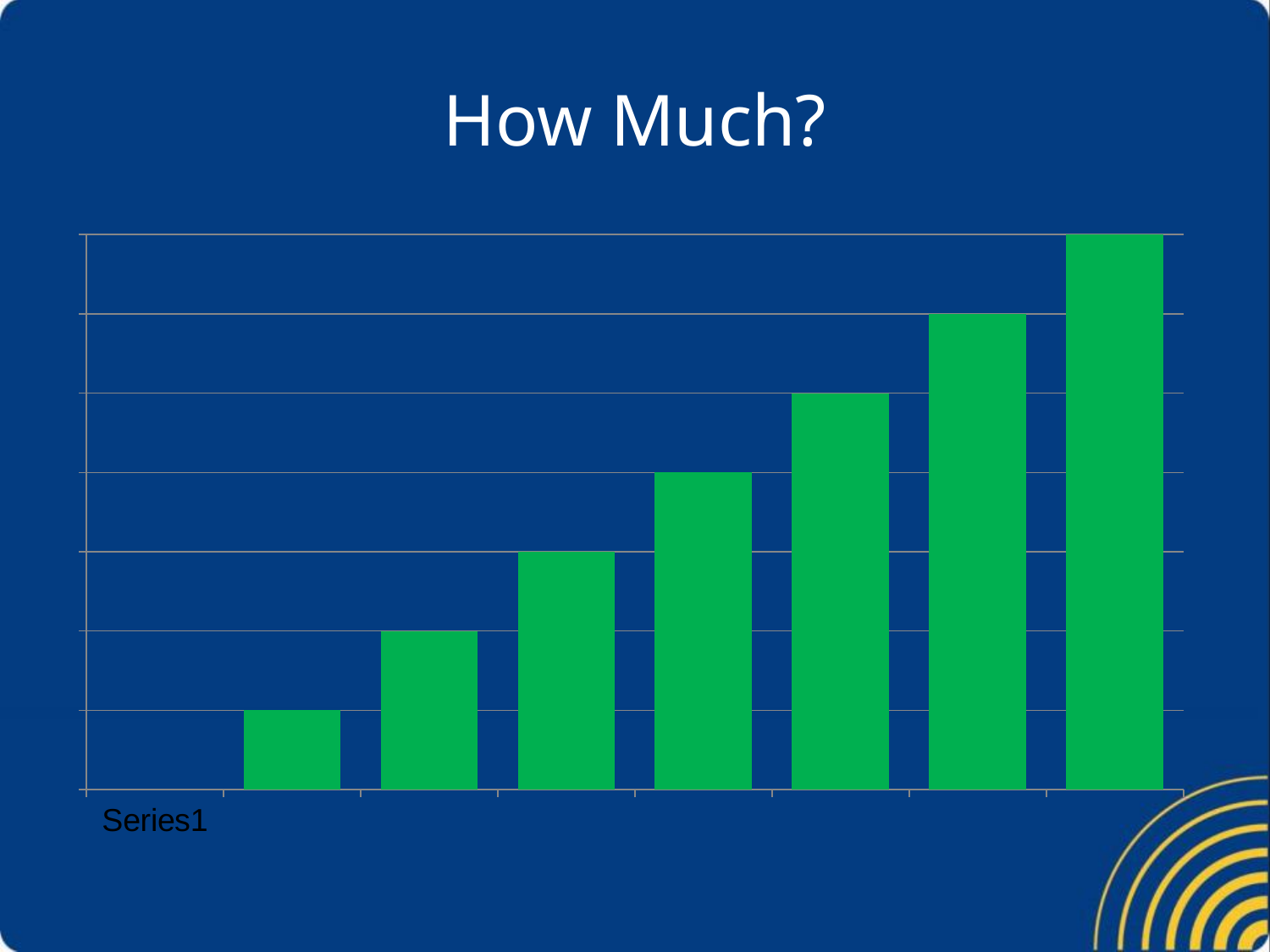
What is the title of the slide containing the chart? How Much? Which bar is the tallest in the chart? the rightmost bar Which bar is the shortest in the chart? the leftmost bar Do the bar values rise or fall from left to right across the chart? rise Which is taller, the second bar from the left or the fourth bar from the left? the fourth bar from the left What colour are the bars in the chart? green Which is taller, the leftmost bar or the rightmost bar? the rightmost bar What kind of chart is shown on the slide? bar chart